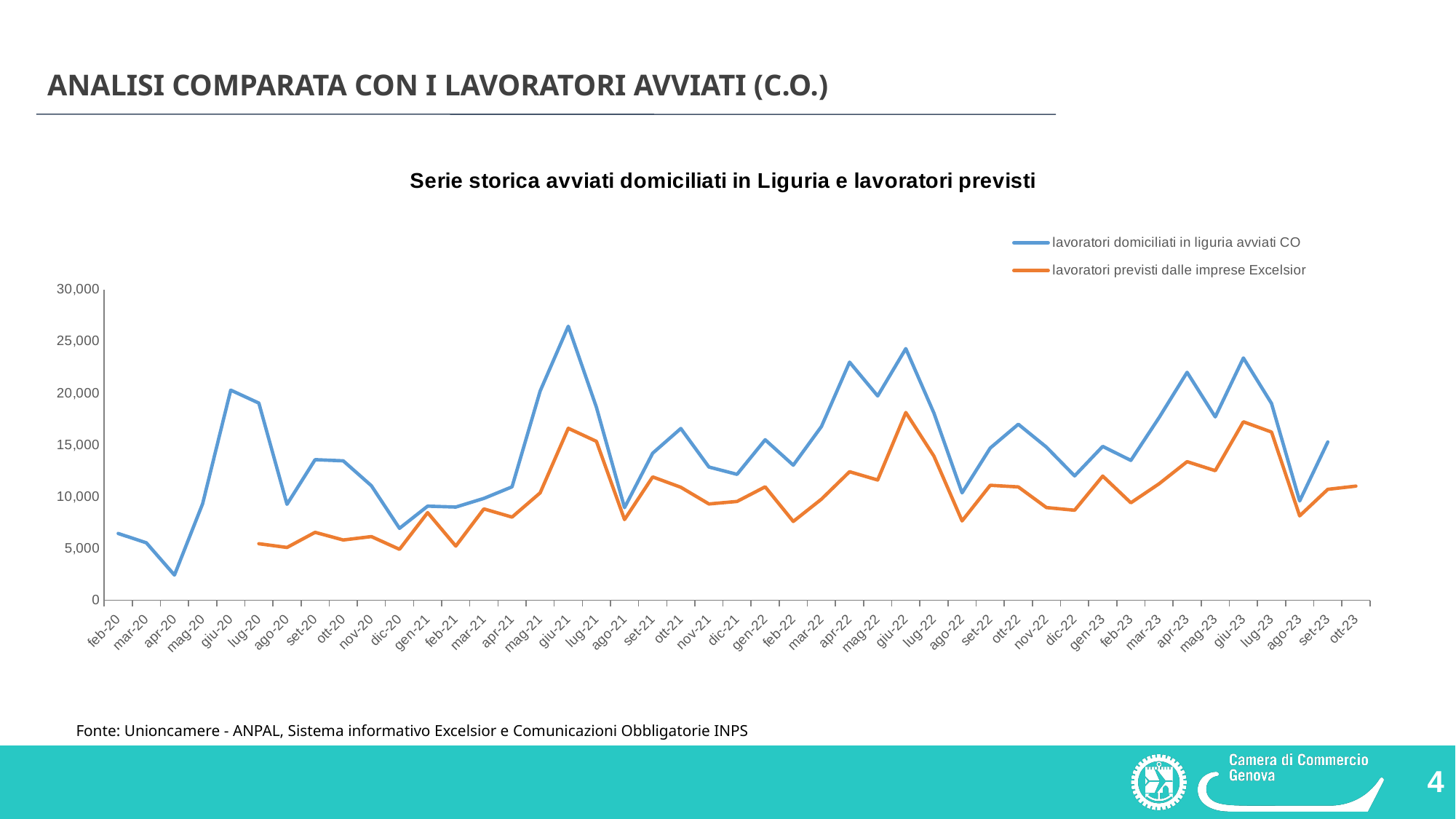
Is the value for 'lavoratori previsti dalle imprese Excelsior' in lug-20 greater or less than 10,000? less Does the series 'lavoratori domiciliati in liguria avviati CO' rise or fall from feb-20 to apr-20? fall In which month does the series 'lavoratori previsti dalle imprese Excelsior' reach its highest value? giu-22 How many months are shown on the x axis? 45 In giu-21, which series has the larger value: 'lavoratori domiciliati in liguria avviati CO' or 'lavoratori previsti dalle imprese Excelsior'? lavoratori domiciliati in liguria avviati CO How many series does the legend list? 2 What is the title of the chart? Serie storica avviati domiciliati in Liguria e lavoratori previsti What kind of chart is shown on the slide? line chart In which month does the series 'lavoratori domiciliati in liguria avviati CO' reach its lowest value? apr-20 Is the value for 'lavoratori domiciliati in liguria avviati CO' in giu-21 greater or less than 25,000? greater Is the value for 'lavoratori domiciliati in liguria avviati CO' in apr-20 greater or less than 5,000? less In which month does the series 'lavoratori domiciliati in liguria avviati CO' reach its highest value? giu-21